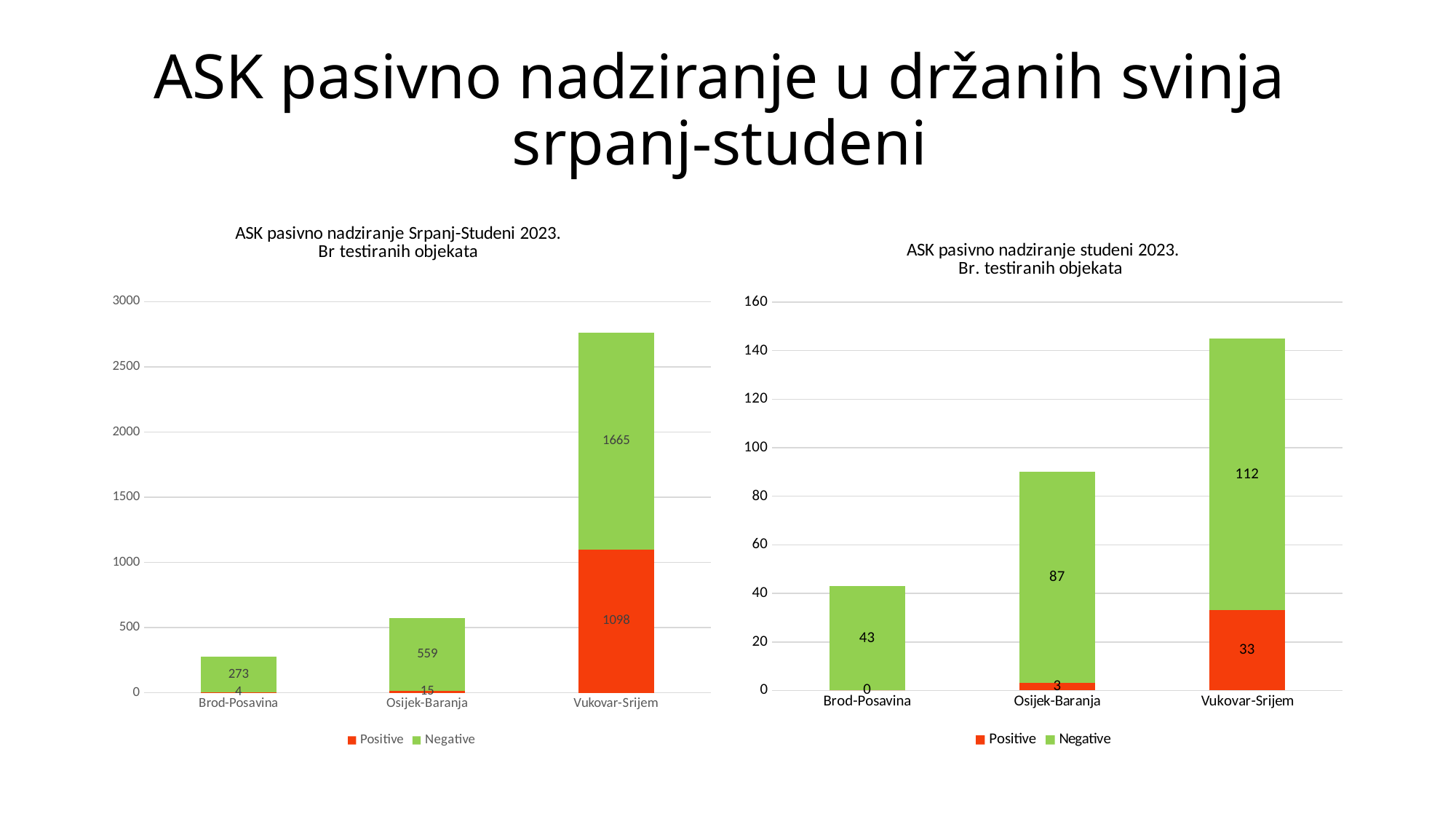
How many series does the legend of the right chart (studeni 2023) list? 2 In the left chart (Srpanj-Studeni 2023), what is the total of the stacked bar for Vukovar-Srijem? 2763 In the left chart (Srpanj-Studeni 2023), what is the difference between the Negative values for Osijek-Baranja and Brod-Posavina? 286 In the right chart (studeni 2023), what is the Negative value for Osijek-Baranja? 87 In the left chart (Srpanj-Studeni 2023), what is the Negative value for Vukovar-Srijem? 1665 In the right chart (studeni 2023), what is the Positive value for Vukovar-Srijem? 33 In the left chart (Srpanj-Studeni 2023), which county has the highest Positive value? Vukovar-Srijem In the right chart (studeni 2023), is the Negative value for Vukovar-Srijem larger than the Negative value for Osijek-Baranja? Yes, Vukovar-Srijem In the left chart (Srpanj-Studeni 2023), what is the Positive value for Osijek-Baranja? 15 In the right chart (studeni 2023), what is the total of the stacked bar for Osijek-Baranja? 90 What type of chart is the left chart (Srpanj-Studeni 2023)? Stacked bar chart In the right chart (studeni 2023), which county has the lowest Negative value? Brod-Posavina